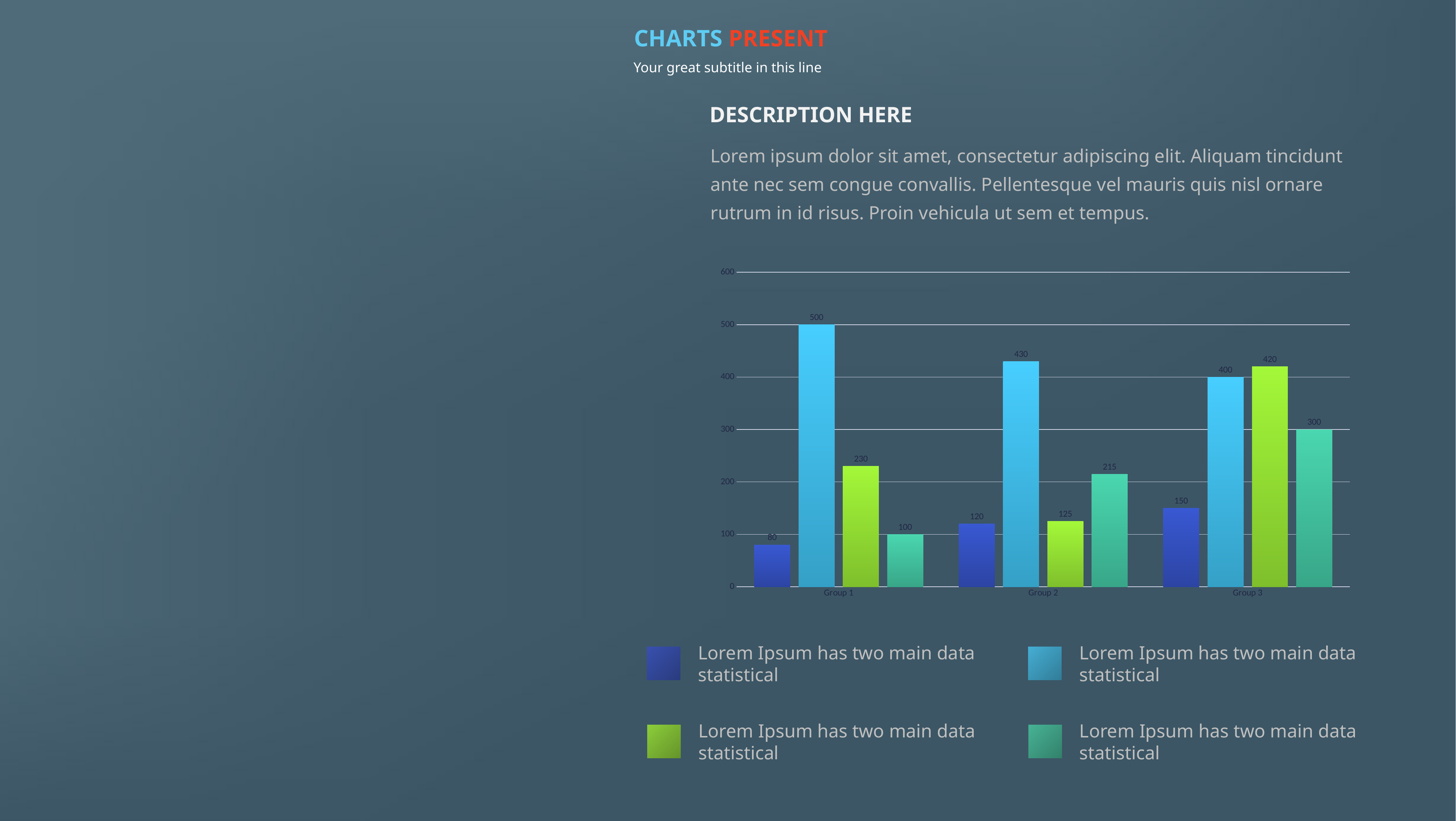
What is the value of the dark blue bar for Group 3? 150 Do the dark blue bar values rise or fall from Group 1 to Group 3? rise What is the value of the green bar for Group 3? 420 What type of chart is shown on the slide? bar chart Which group has the lowest dark blue bar? Group 1 Which group has the highest light blue bar? Group 1 What is the value of the teal bar for Group 2? 215 What is the value of the light blue bar for Group 1? 500 How many groups are shown on the x axis of the chart? 3 How many series does the legend below the chart list? 4 Which is larger for Group 3, the light blue bar or the green bar? the green bar What is the difference between the light blue bar and the green bar for Group 2? 305